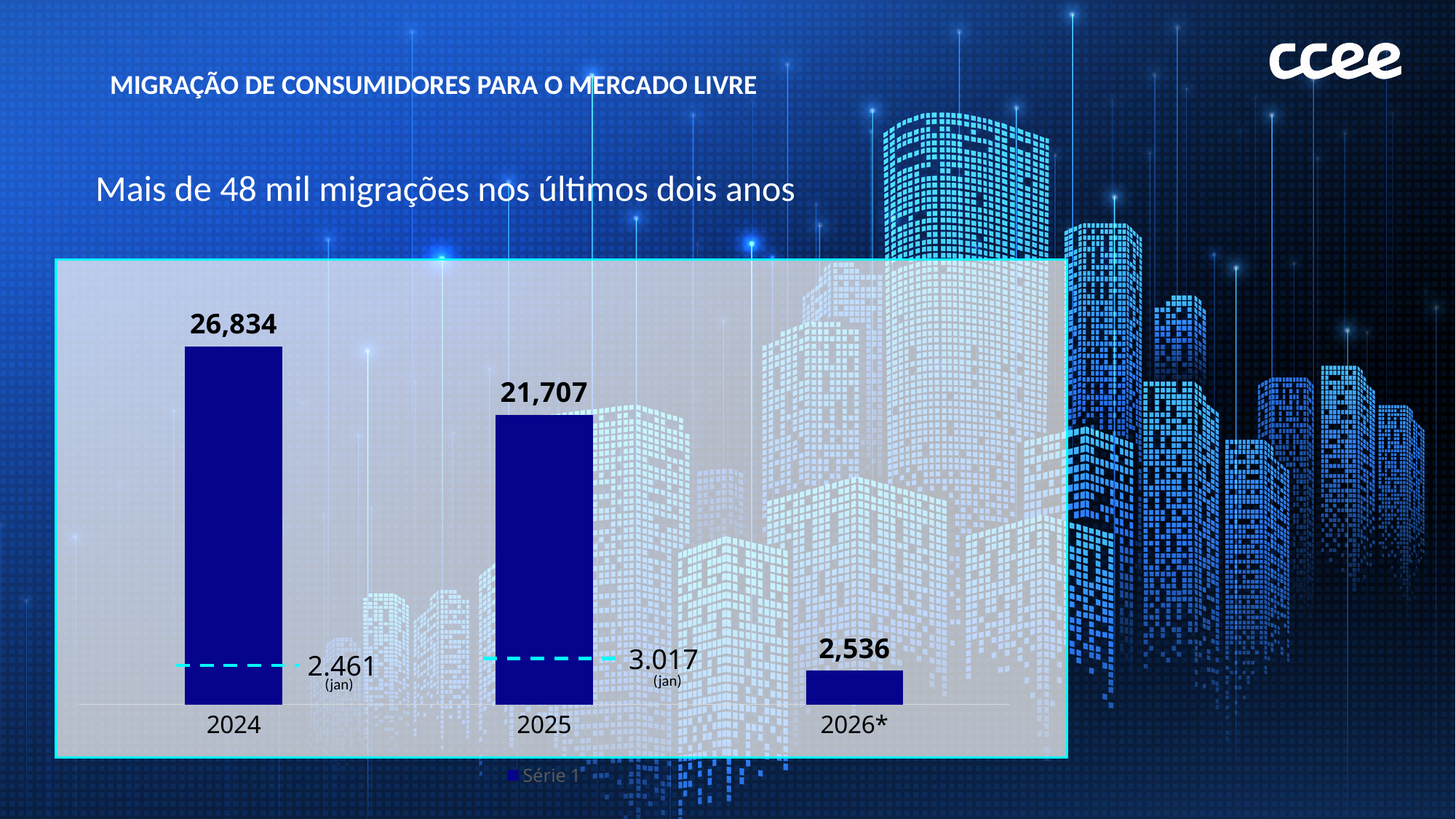
What is the difference between the values for 2025 and 2026*? 19,171 Do the values rise or fall from 2024 to 2026*? Fall What is the value shown for 2024? 26,834 How many bars are plotted in the chart? 3 Which is larger, the value for 2024 or the value for 2025? 2024 Which year has the lowest value? 2026* What kind of chart is shown on the slide? Bar chart What is the value shown for 2025? 21,707 Which year has the highest value? 2024 What is the difference between the values for 2024 and 2025? 5,127 What value is annotated next to the dashed line for January (jan) 2025? 3.017 What is the value shown for 2026*? 2,536